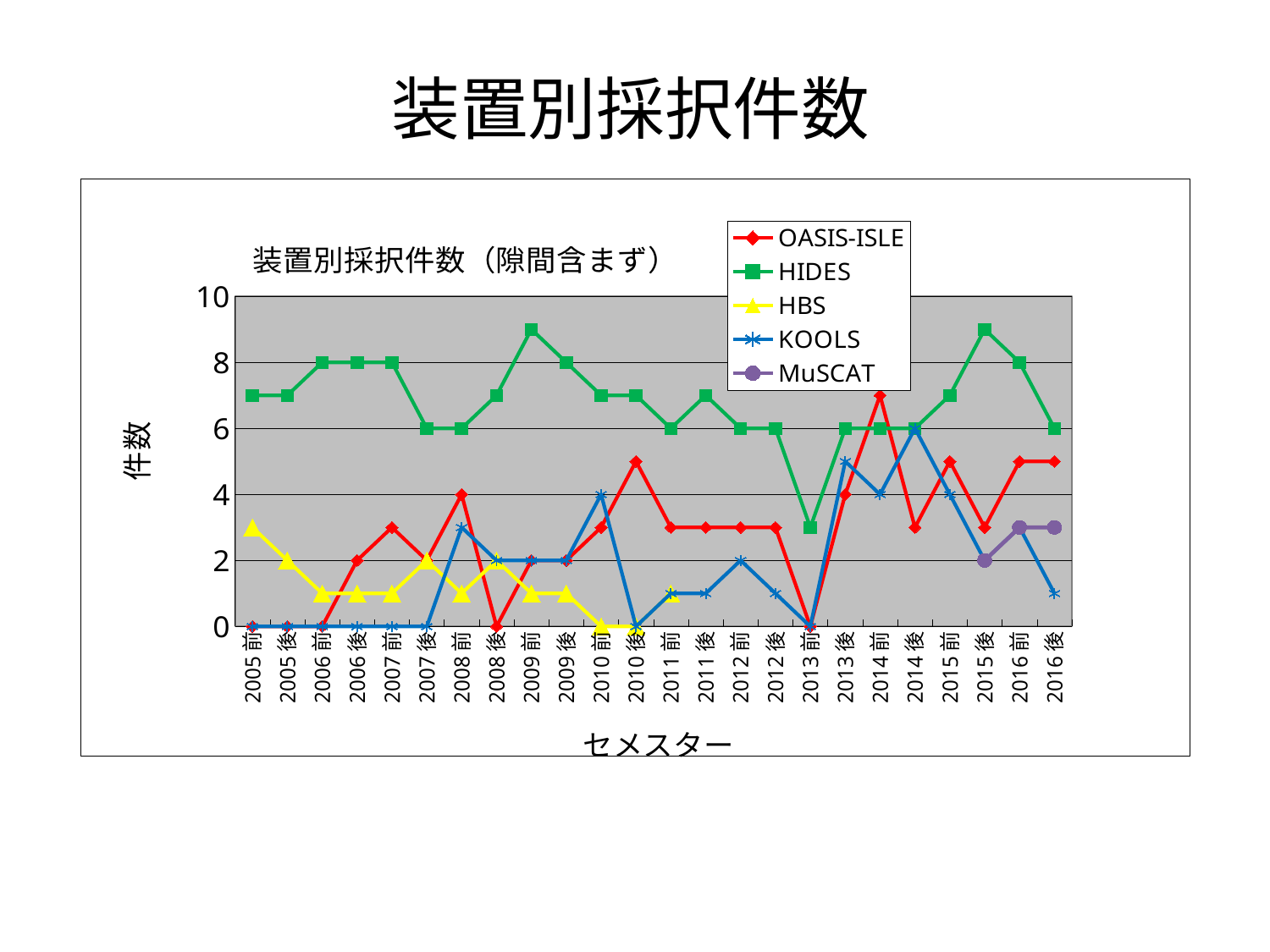
Is the value for HIDES in 2009 前 greater or less than 8? greater What is the value for OASIS-ISLE in 2008 前? 4 What is the difference between the HIDES value and the OASIS-ISLE value in 2006 前? 8 In which semester is the HIDES value lowest? 2013 前 How many semesters are shown along the x axis? 24 What is the value for KOOLS in 2014 後? 6 What kind of chart is shown on the slide? line chart What is the value for MuSCAT in 2015 後? 2 Which series has the larger value in 2006 前, HIDES or OASIS-ISLE? HIDES How many series does the legend list? 5 What is the title printed inside the chart area? 装置別採択件数（隙間含まず） What is the value for HIDES in 2006 前? 8